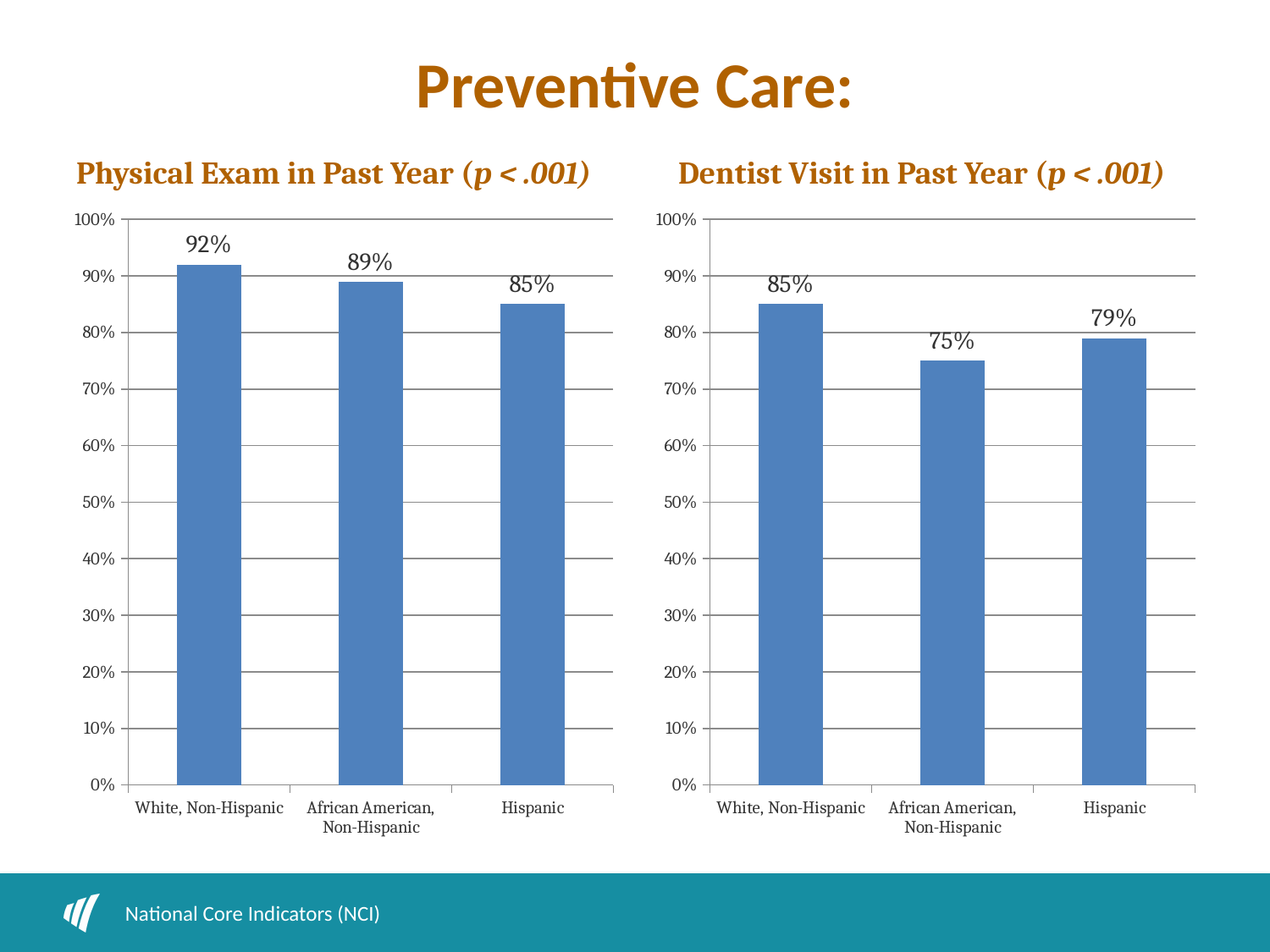
In the Physical Exam in Past Year chart, which category has the highest value? White, Non-Hispanic In the Physical Exam in Past Year chart, what is the value for Hispanic? 85% In the Physical Exam in Past Year chart, what is the value for White, Non-Hispanic? 92% In the Physical Exam in Past Year chart, do the values rise or fall from left to right along the x axis? fall How many categories are shown in the Dentist Visit in Past Year chart? 3 In the Dentist Visit in Past Year chart, what is the value for African American, Non-Hispanic? 75% In the Physical Exam in Past Year chart, what is the difference between the values for White, Non-Hispanic and African American, Non-Hispanic? 3% In the Dentist Visit in Past Year chart, which category has the lowest value? African American, Non-Hispanic In the Dentist Visit in Past Year chart, what is the difference between the values for White, Non-Hispanic and Hispanic? 6% What kind of chart is the Physical Exam in Past Year chart? bar chart In the Dentist Visit in Past Year chart, what is the value for Hispanic? 79% In the Dentist Visit in Past Year chart, which is larger, the value for Hispanic or the value for African American, Non-Hispanic? Hispanic